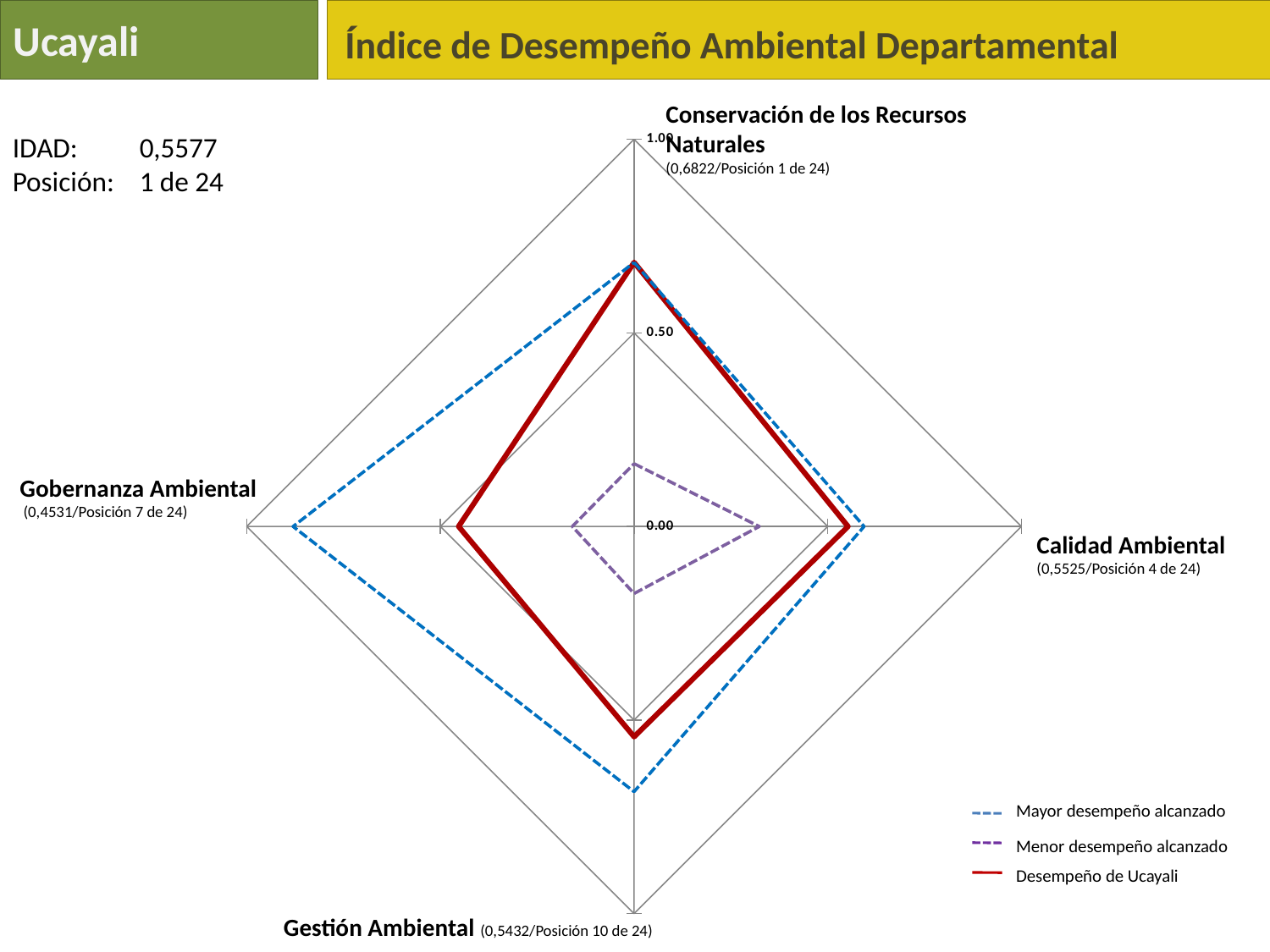
Which series is drawn with a solid red line? Desempeño de Ucayali How many series does the legend list? 3 Which is larger for Ucayali: Calidad Ambiental or Gestión Ambiental? Calidad Ambiental What is the difference between Ucayali's values for Conservación de los Recursos Naturales and Gobernanza Ambiental? 0,2291 In which category does Ucayali have its highest value? Conservación de los Recursos Naturales What position does Ucayali hold in Gestión Ambiental? 10 de 24 What type of chart is shown on the slide? Radar chart Is the 'Mayor desempeño alcanzado' value for Gobernanza Ambiental greater or less than 0.50? greater In which category does Ucayali have its lowest value? Gobernanza Ambiental What is Ucayali's value for Gobernanza Ambiental? 0,4531 What is Ucayali's value for Conservación de los Recursos Naturales? 0,6822 How many axes (categories) does the radar chart have? 4